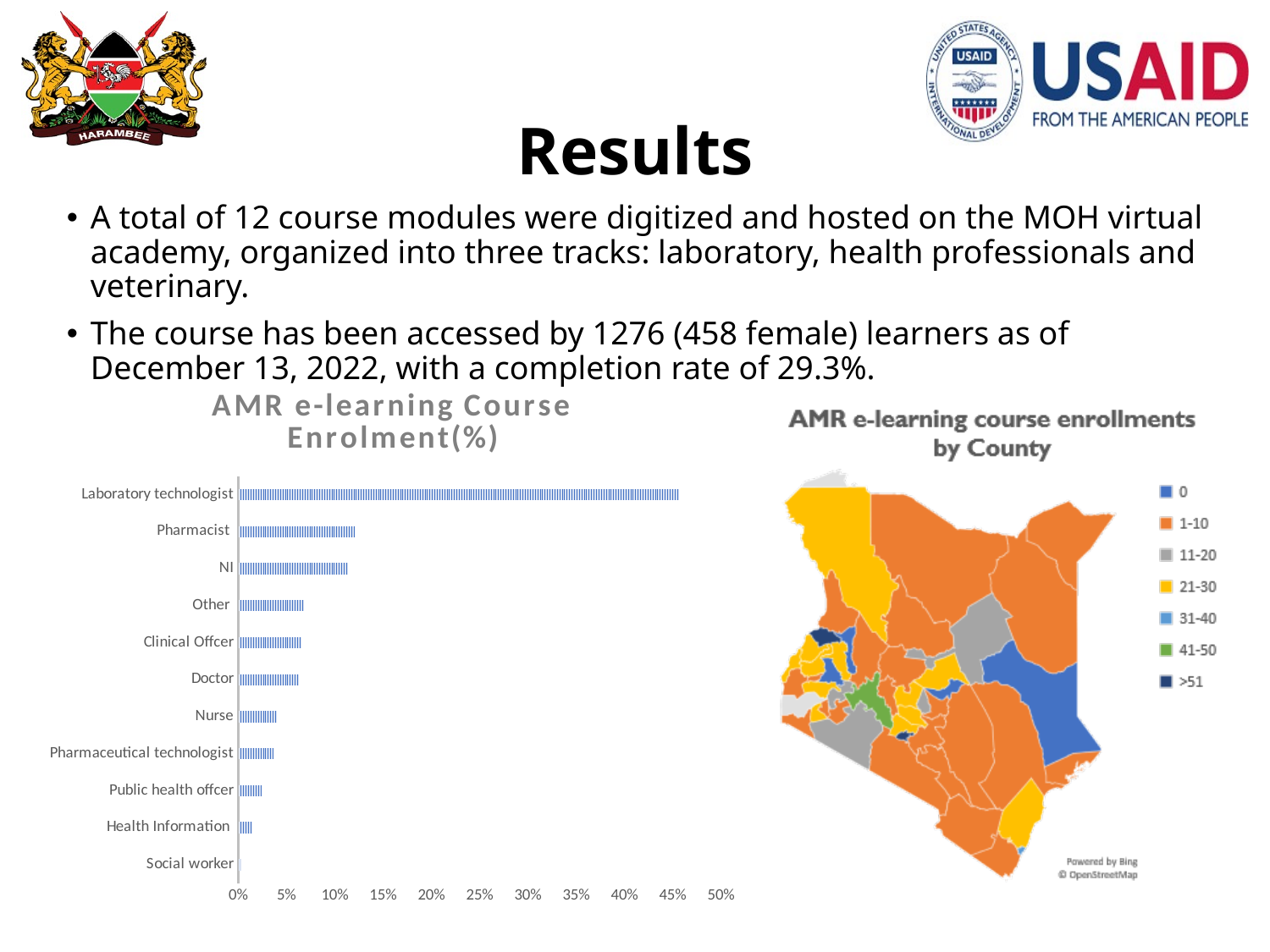
What is the highest tick value shown on the x axis of the 'AMR e-learning Course Enrolment(%)' chart? 50% How many categories are shown on the 'AMR e-learning Course Enrolment(%)' chart? 11 On the 'AMR e-learning Course Enrolment(%)' chart, which category has the lowest value? Social worker What kind of chart is the 'AMR e-learning Course Enrolment(%)' chart? bar chart What is the title of the chart on the right side of the slide? AMR e-learning course enrollments by County On the 'AMR e-learning Course Enrolment(%)' chart, which category has the highest value? Laboratory technologist How many ranges does the legend of the 'AMR e-learning course enrollments by County' chart list? 7 On the 'AMR e-learning Course Enrolment(%)' chart, which is larger, the value for Doctor or the value for Nurse? Doctor On the 'AMR e-learning Course Enrolment(%)' chart, is the value for Laboratory technologist greater or less than 40%? greater On the 'AMR e-learning Course Enrolment(%)' chart, is the value for Nurse greater or less than 5%? less On the 'AMR e-learning Course Enrolment(%)' chart, is the value for Other greater or less than 10%? less On the 'AMR e-learning Course Enrolment(%)' chart, which is larger, the value for Laboratory technologist or the value for Pharmacist? Laboratory technologist